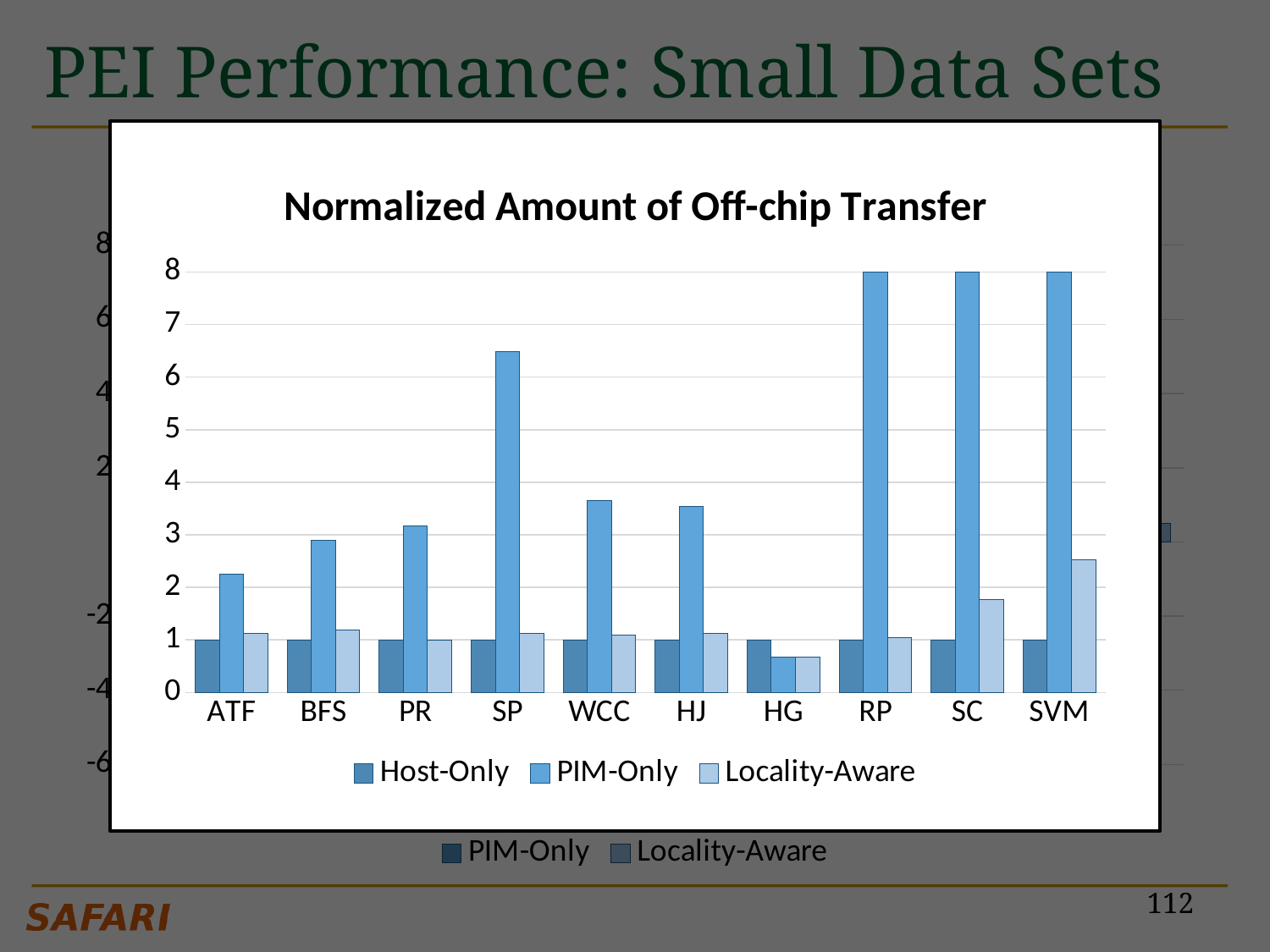
In the chart titled "Normalized Amount of Off-chip Transfer", is the Locality-Aware value for SVM greater or less than 2? greater In the chart titled "Normalized Amount of Off-chip Transfer", how many categories are shown on the x axis? 10 In the chart titled "Normalized Amount of Off-chip Transfer", how many series does the legend list? 3 In the chart titled "Normalized Amount of Off-chip Transfer", which is larger: the PIM-Only value for SP or the PIM-Only value for BFS? SP In the chart titled "Normalized Amount of Off-chip Transfer", is the PIM-Only value for WCC greater or less than 4? less In the chart titled "Normalized Amount of Off-chip Transfer", which category has the lowest Locality-Aware value? HG In the chart titled "Normalized Amount of Off-chip Transfer", is the PIM-Only value for SP greater or less than 6? greater In the chart titled "Normalized Amount of Off-chip Transfer", which series is listed first in the legend? Host-Only In the chart titled "Normalized Amount of Off-chip Transfer", which is larger: the Locality-Aware value for SVM or the Locality-Aware value for SC? SVM In the chart titled "Normalized Amount of Off-chip Transfer", what kind of chart is shown? bar chart In the chart titled "Normalized Amount of Off-chip Transfer", what is the Host-Only value for ATF? 1